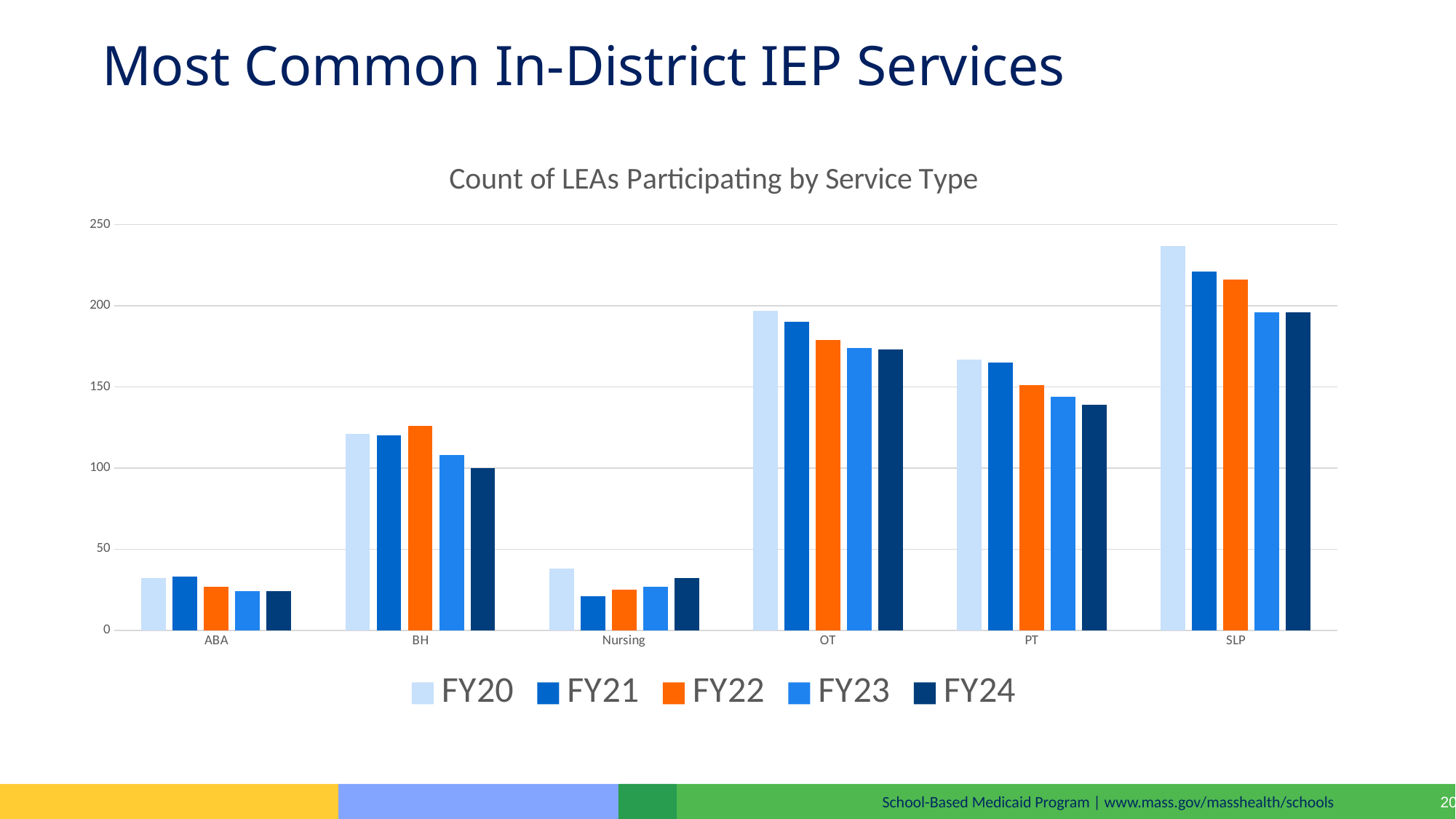
Is the FY20 value for OT greater or less than 150? greater What kind of chart is shown on the slide? bar chart Which is larger for FY20: the value for OT or the value for PT? OT What is the title of the chart? Count of LEAs Participating by Service Type Do the PT values rise or fall from FY20 to FY24? fall How many service types are shown on the x axis? 6 Is the FY24 value for PT greater or less than 150? less Is the FY20 value for SLP greater or less than 200? greater Which service type has the highest FY20 count of LEAs? SLP Which service type has the lowest FY20 count of LEAs? ABA How many series does the legend list? 5